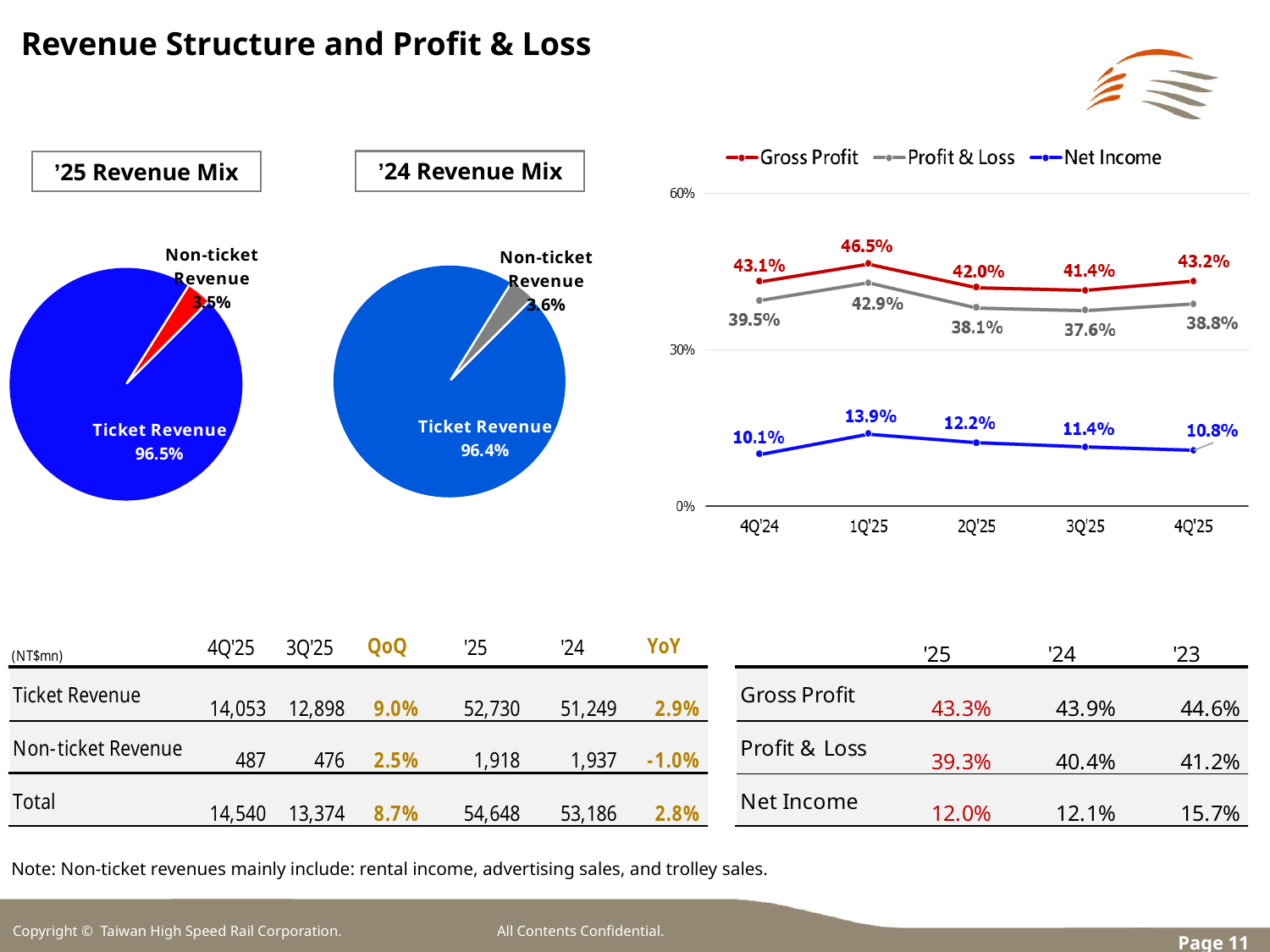
In the line chart on the right, how many series does the legend list? 3 In the '24 Revenue Mix pie chart, what share is Non-ticket Revenue? 3.6% In the line chart on the right, in which quarter is Profit & Loss lowest? 3Q'25 What kind of chart is the '25 Revenue Mix chart? Pie chart In the line chart on the right, how many quarters are shown on the x axis? 5 In the line chart on the right, does Net Income rise or fall from 1Q'25 to 4Q'25? Fall In the line chart on the right, what is the Gross Profit value for 1Q'25? 46.5% In the line chart on the right, in which quarter is Net Income highest? 1Q'25 In the line chart on the right, is the Gross Profit value for 4Q'24 greater or less than 30%? greater In the '25 Revenue Mix pie chart, what share is Ticket Revenue? 96.5% In the line chart on the right, what is the difference between Gross Profit and Profit & Loss in 4Q'25? 4.4 percentage points In the line chart on the right, is Net Income higher in 2Q'25 or 3Q'25? 2Q'25